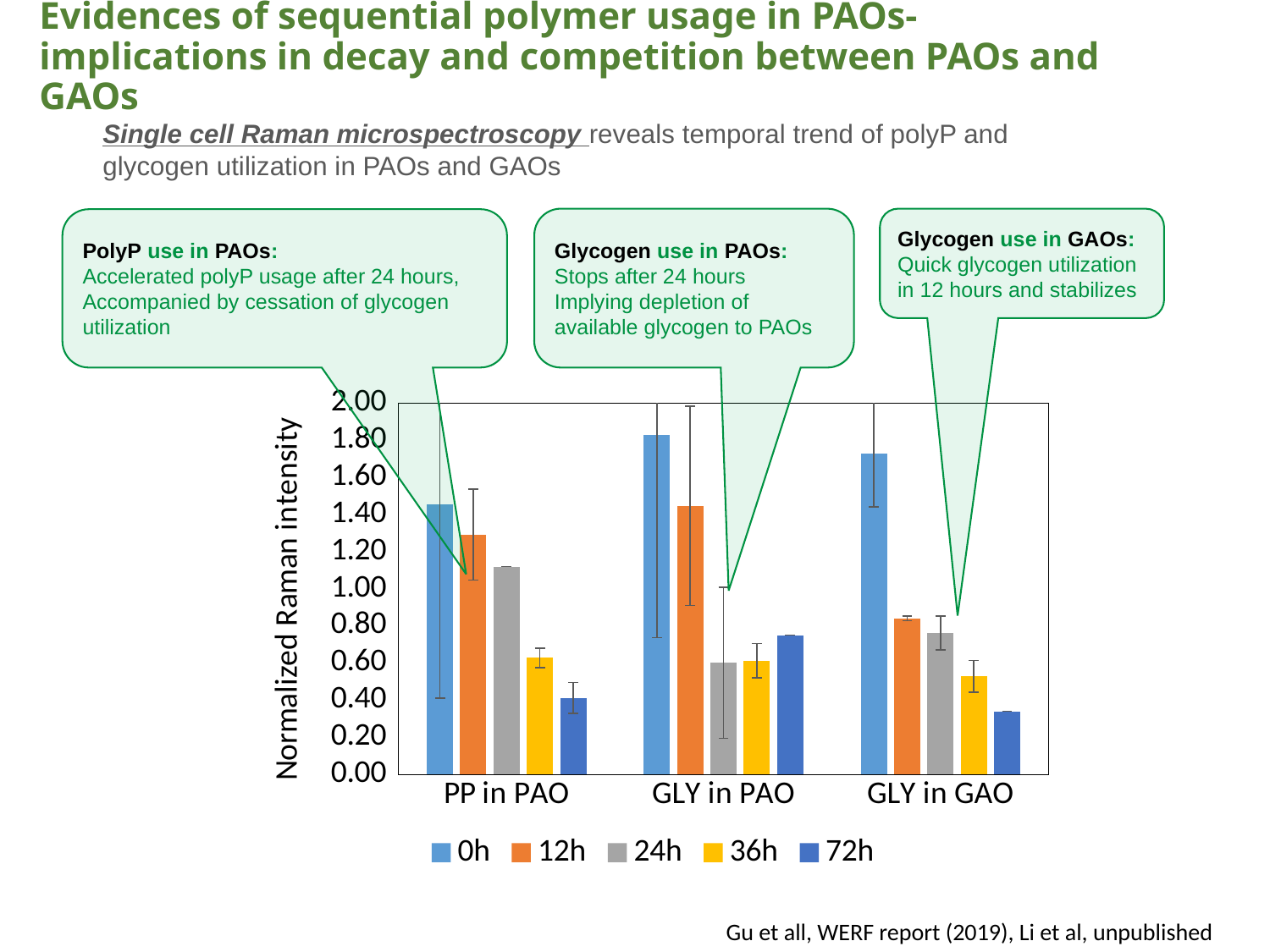
Is the 0h value for PP in PAO greater or less than 1.20? greater Is the 12h value for GLY in GAO greater or less than 1.00? less Which time point has the highest value for GLY in GAO? 0h Is the 72h value for PP in PAO greater or less than 0.60? less Which time point has the lowest value for PP in PAO? 72h How many series does the chart legend list? 5 How many categories are shown on the x axis of the chart? 3 For GLY in GAO, which is larger: the 0h value or the 72h value? 0h What is the label of the y axis of the chart? Normalized Raman intensity For PP in PAO, do the values rise or fall from 0h to 72h? fall What kind of chart is shown on the slide? bar chart